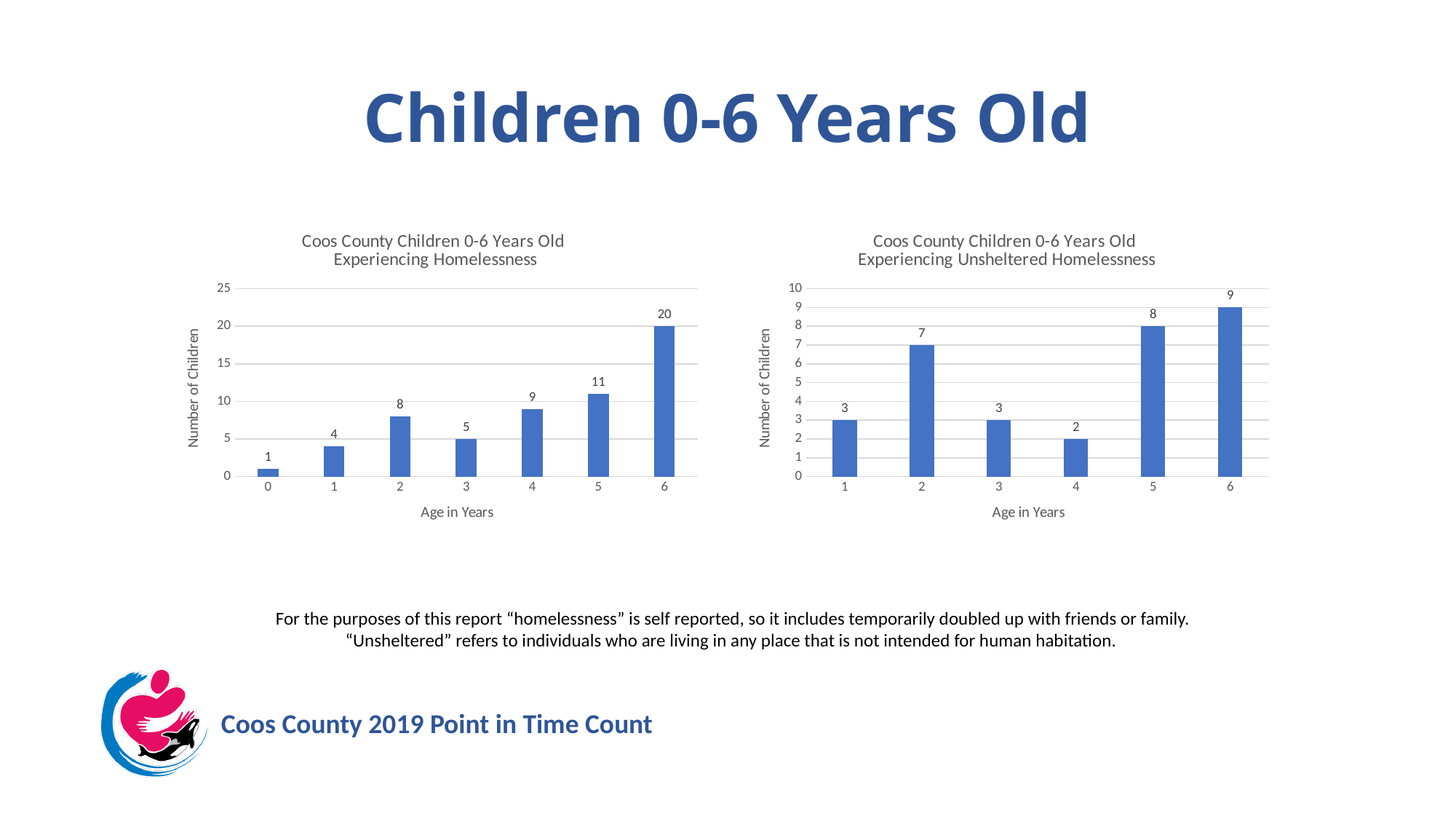
In the left chart (Experiencing Homelessness), which is larger: the value for age 2 or the value for age 3? age 2 In the left chart (Experiencing Homelessness), what is the difference between the number of children age 6 and age 5? 9 How many age categories are shown in the left chart (Experiencing Homelessness)? 7 In the right chart (Experiencing Unsheltered Homelessness), which age has the lowest number of children? 4 In the left chart (Experiencing Homelessness), how many children are age 6? 20 In the right chart (Experiencing Unsheltered Homelessness), how many children are age 2? 7 How many age categories are shown in the right chart (Experiencing Unsheltered Homelessness)? 6 In the left chart (Experiencing Homelessness), how many children are age 3? 5 In the left chart (Experiencing Homelessness), which age has the lowest number of children? 0 In the right chart (Experiencing Unsheltered Homelessness), which age has the highest number of children? 6 In the right chart (Experiencing Unsheltered Homelessness), what is the difference between the number of children age 5 and age 4? 6 What type of chart is the right chart (Experiencing Unsheltered Homelessness)? bar chart